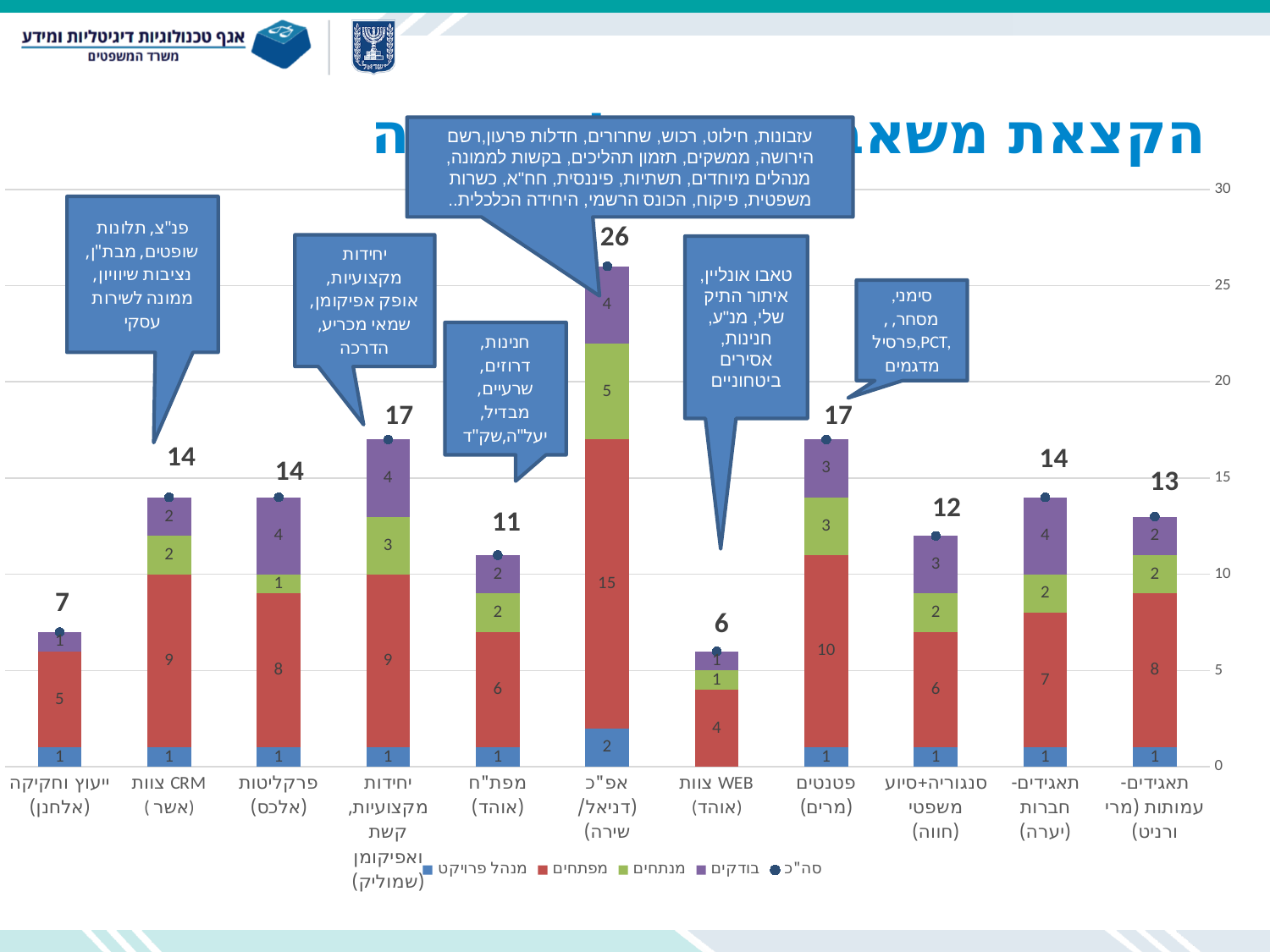
Which category has the lowest total? WEB צוות (אוהד) How many entries does the legend list? 5 What is the מנתחים value for יחידות מקצועיות, קשת ואפיקומן (שמוליק)? 3 Which category has the highest total? אפ"כ (דניאל/שירה) What is the מפתחים value for פטנטים (מרים)? 10 Which has a larger total, פטנטים (מרים) or סנגוריה+סיוע משפטי (חווה)? פטנטים (מרים) What is the total value shown for אפ"כ (דניאל/שירה)? 26 What is the total of the stacked bar for תאגידים-עמותות (מרי ורניט)? 13 What kind of chart is shown? Stacked bar chart How many categories are shown on the x axis? 11 What is the difference between the totals of אפ"כ (דניאל/שירה) and WEB צוות (אוהד)? 20 What is the בודקים value for פרקליטות (אלכס)? 4